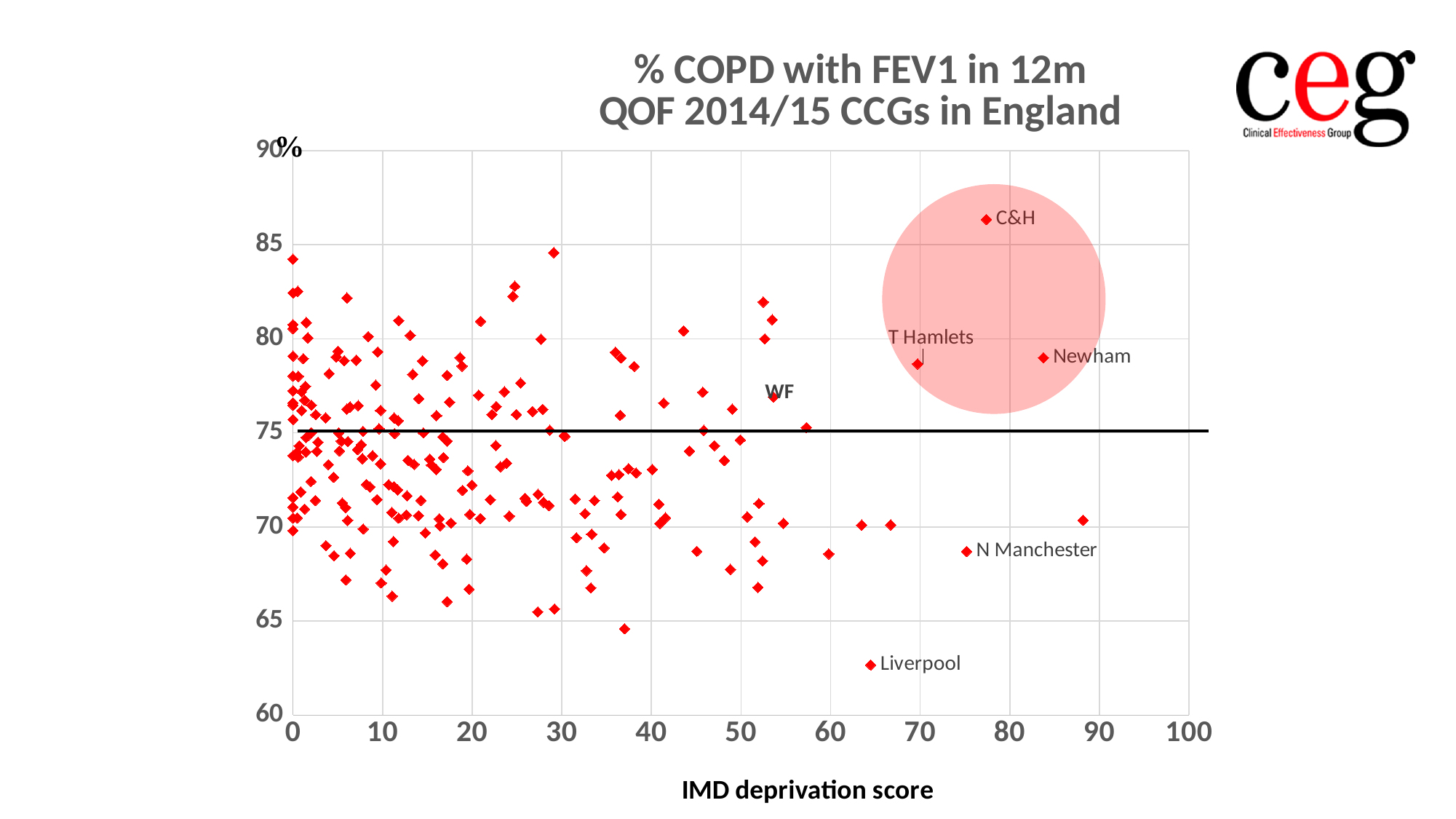
Which labelled CCG has the highest % COPD with FEV1 in 12m? C&H Is the value for C&H greater or less than 85? greater Is the value for Liverpool greater or less than 65? less Is the value for Newham greater or less than 80? less What is the label of the x axis? IMD deprivation score Which has the higher value, C&H or T Hamlets? C&H What kind of chart is shown on the slide? Scatter chart Which labelled CCG has the lowest % COPD with FEV1 in 12m? Liverpool At what value on the y axis is the horizontal line drawn? 75 Which has the higher value, Newham or N Manchester? Newham